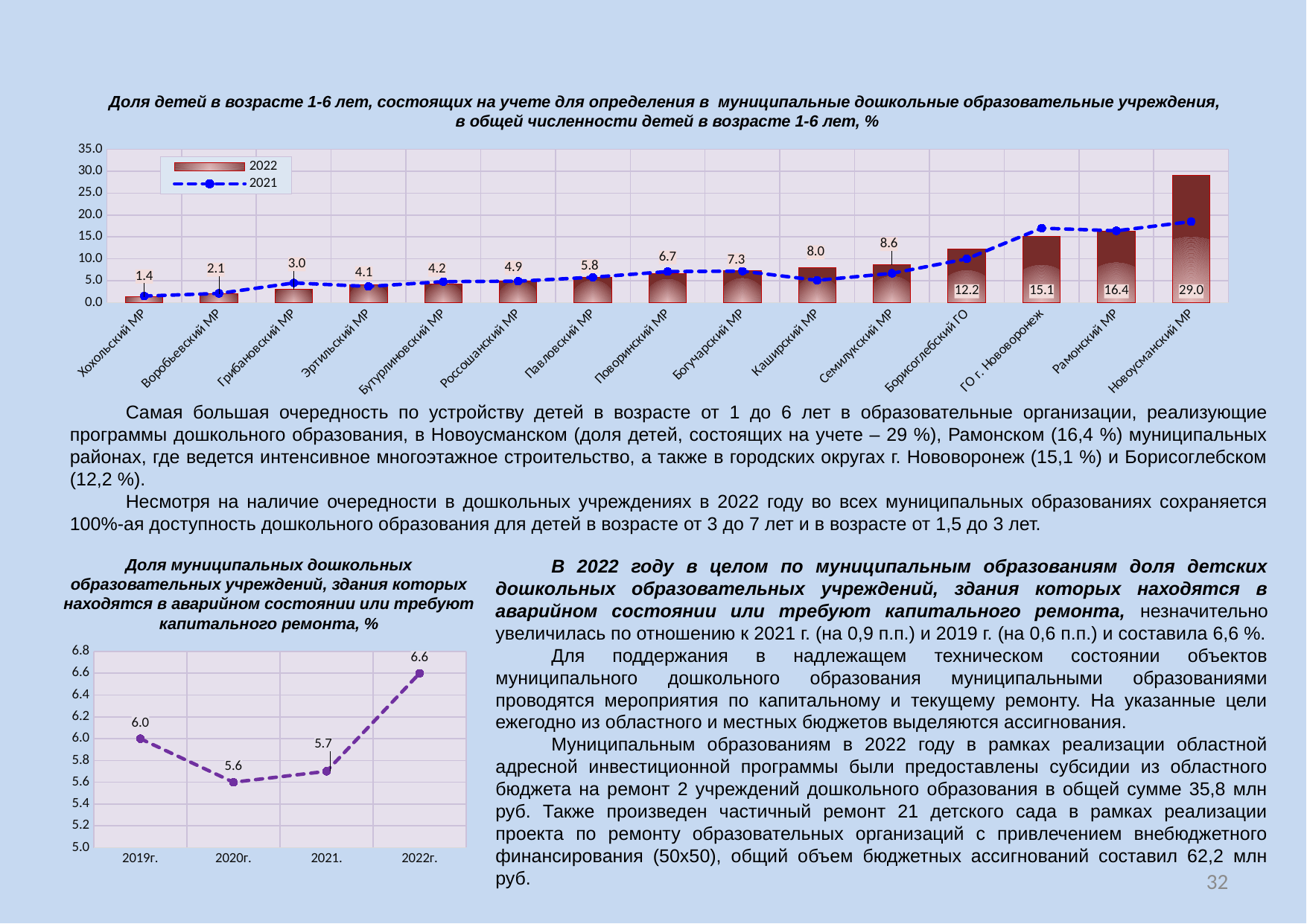
What type of chart is the bottom-left chart? line chart In the top chart, what is the 2022 value for Борисоглебский ГО? 12.2 In the top chart, which municipality has the highest 2022 value? Новоусманский МР In the top chart, which municipality has the lowest 2022 value? Хохольский МР In the top chart, which has a larger 2022 value: Поворинский МР or Каширский МР? Каширский МР In the top chart, is the 2021 value for Новоусманский МР greater or less than 15.0? greater In the top chart, how many municipalities are shown on the x axis? 15 In the bottom-left chart, what is the difference between the values for 2022г. and 2019г.? 0.6 In the top chart, how many series does the legend list? 2 In the bottom-left chart (share of municipal preschool institutions in emergency condition or requiring major repair), what is the value for 2020г.? 5.6 In the top chart, what is the difference between the 2022 values for Рамонский МР and ГО г. Нововоронеж? 1.3 In the top chart (share of children aged 1-6 registered for municipal preschool institutions), what is the 2022 value for Новоусманский МР? 29.0